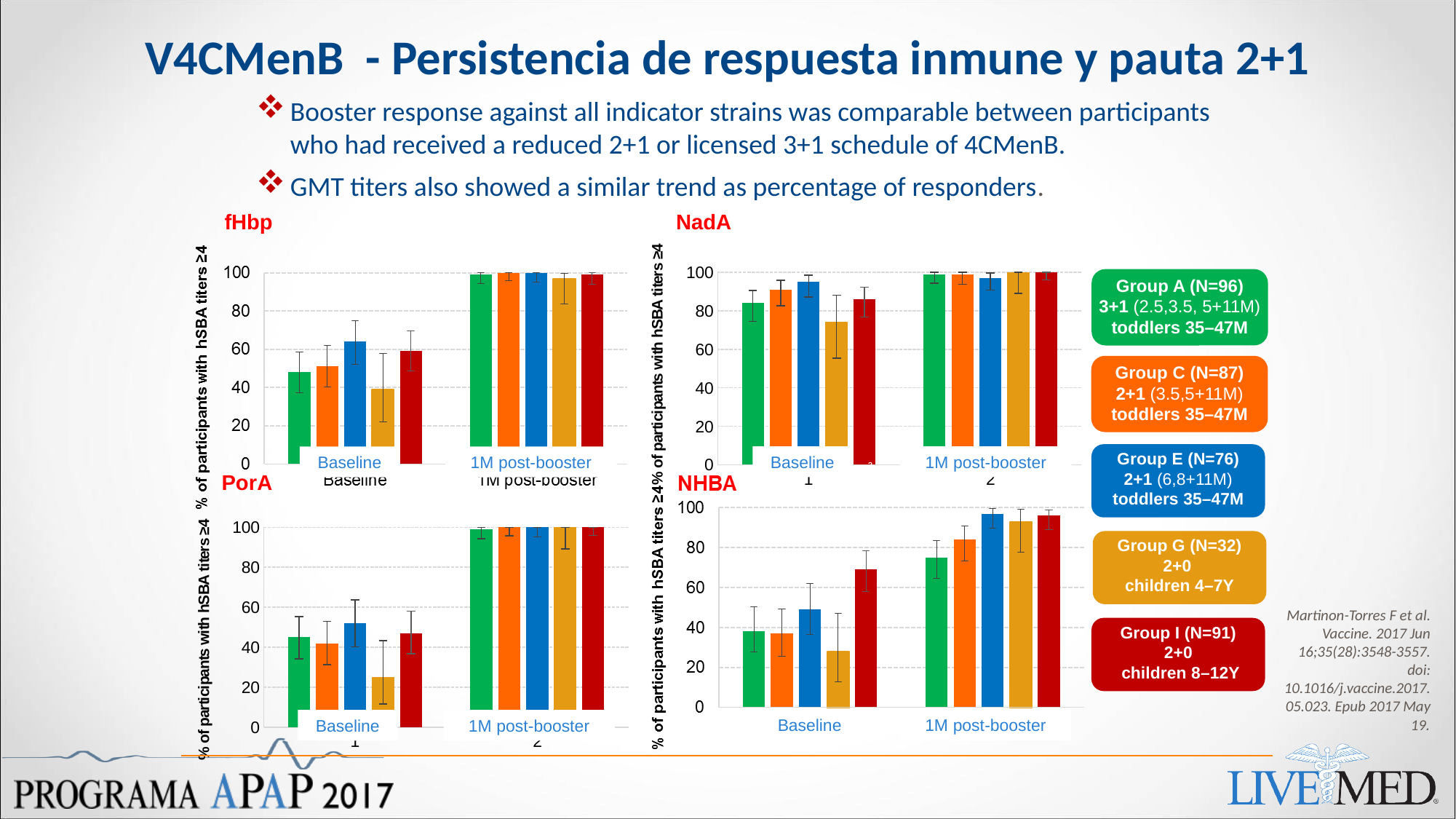
In the PorA chart, is the Baseline value for Group G greater or less than 40? less How many time-point categories are shown on the x axis of the NHBA chart? 2 In the PorA chart, which group has the lowest value at Baseline? Group G In the NadA chart, is the Baseline value for Group G greater or less than 80? less In the NHBA chart, which is larger at Baseline: Group I or Group A? Group I In the NHBA chart, is the Baseline value for Group I greater or less than 60? greater In the NHBA chart, which group has the highest value at Baseline? Group I How many groups does the legend list for the charts? 5 In the PorA chart, do the values rise or fall from Baseline to 1M post-booster? rise In the NHBA chart, which group has the lowest value at Baseline? Group G What kind of chart is the fHbp chart? bar chart